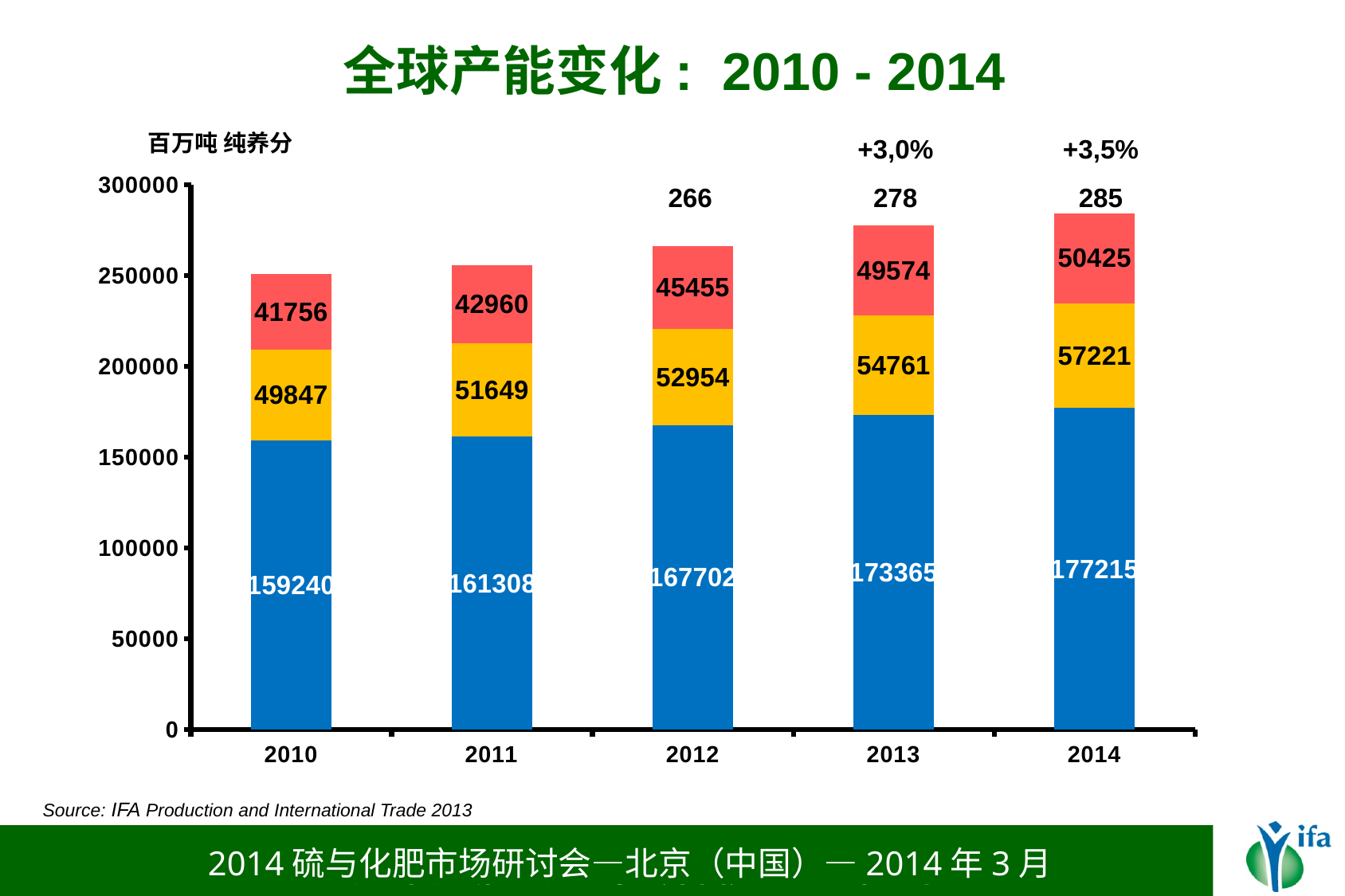
What is the value of the red (top) segment for 2014? 50425 Is the yellow (middle) segment value for 2013 larger or smaller than that for 2012? larger What is the value of the blue (bottom) segment for 2012? 167702 What percentage change is printed above the 2014 bar? +3,5% What is the difference between the blue (bottom) segment values for 2014 and 2010? 17975 How many years are shown on the x axis of the chart? 5 Which year has the lowest value for the red (top) segment? 2010 Which year has the highest value for the blue (bottom) segment? 2014 What is the total of the stacked bar for 2010, computed from its three segment labels? 250843 What is the value of the yellow (middle) segment for 2011? 51649 What type of chart is shown on the slide? stacked bar chart Do the blue (bottom) segment values rise or fall from 2010 to 2014? rise